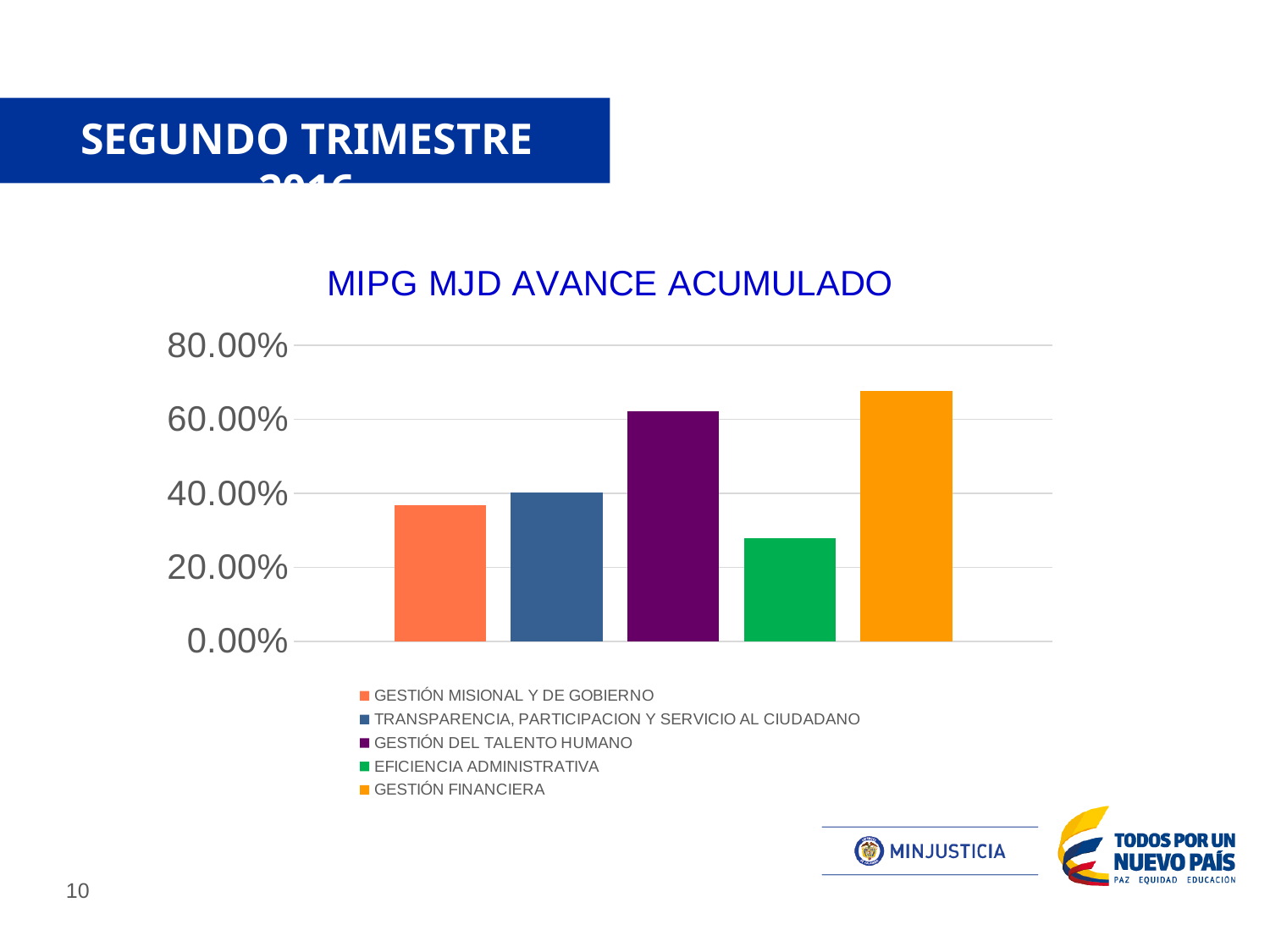
How many bars are plotted in the chart? 5 Is the value for GESTIÓN DEL TALENTO HUMANO greater or less than 40.00%? greater Which is larger, the value for GESTIÓN MISIONAL Y DE GOBIERNO or the value for EFICIENCIA ADMINISTRATIVA? GESTIÓN MISIONAL Y DE GOBIERNO Is the value for GESTIÓN FINANCIERA greater or less than 60.00%? greater What kind of chart is shown on the slide? Bar chart How many entries does the legend list? 5 Which is larger, the value for GESTIÓN FINANCIERA or the value for GESTIÓN DEL TALENTO HUMANO? GESTIÓN FINANCIERA Which category has the highest value in the chart? GESTIÓN FINANCIERA Which category has the lowest value in the chart? EFICIENCIA ADMINISTRATIVA Is the value for EFICIENCIA ADMINISTRATIVA greater or less than 40.00%? less What is the title of the chart? MIPG MJD AVANCE ACUMULADO What colour is the bar for GESTIÓN DEL TALENTO HUMANO? Purple